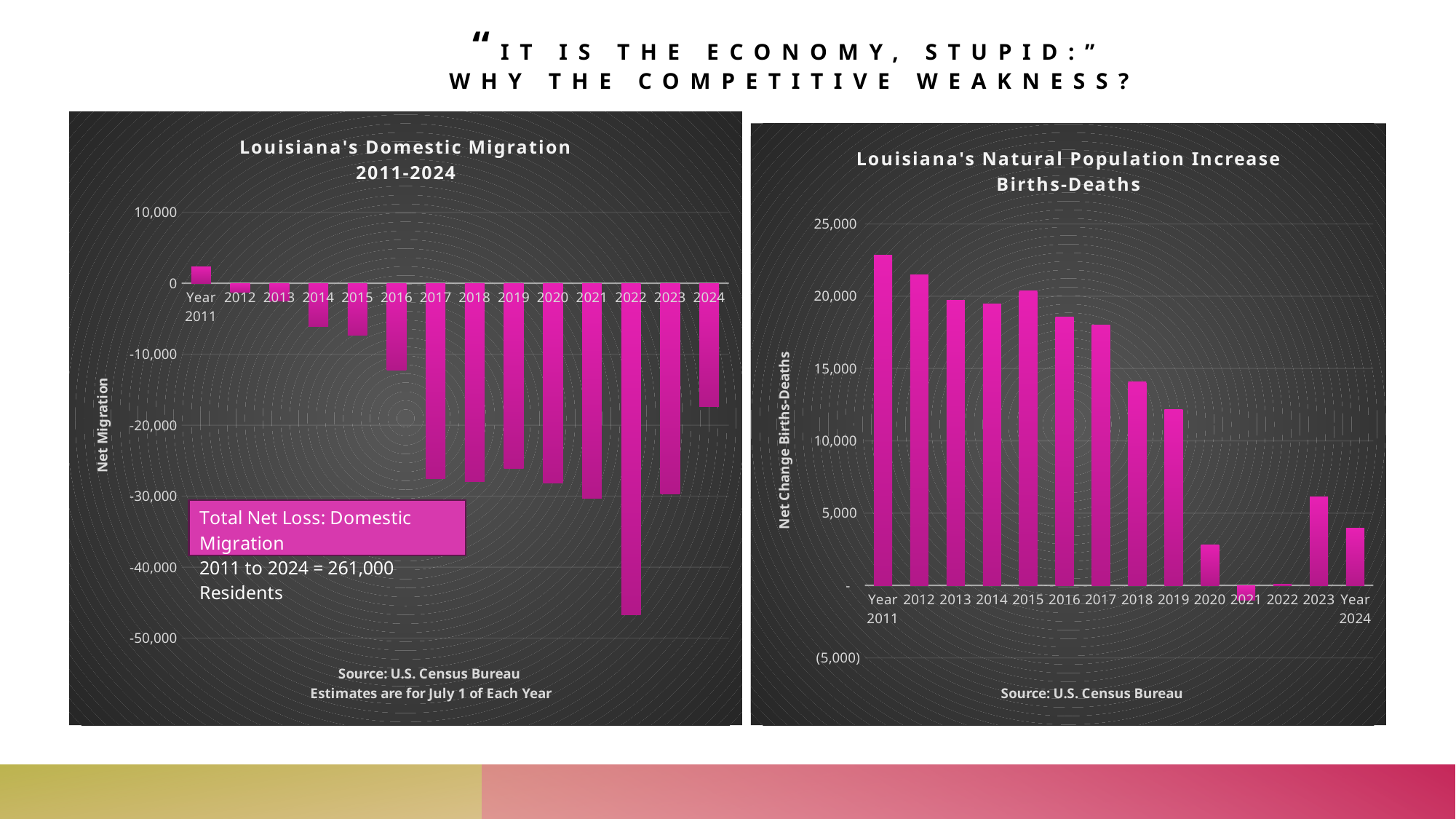
In the "Louisiana's Domestic Migration 2011-2024" chart, which year is the only one with positive net migration? 2011 In the "Louisiana's Domestic Migration 2011-2024" chart, is the value for 2016 greater or less than -10,000? less In the "Louisiana's Natural Population Increase Births-Deaths" chart, which is larger, the value for 2023 or the value for 2024? 2023 In the "Louisiana's Natural Population Increase Births-Deaths" chart, do the values generally rise or fall from 2011 to 2020? fall In the "Louisiana's Domestic Migration 2011-2024" chart, which year has the lowest (most negative) net migration? 2022 In the "Louisiana's Natural Population Increase Births-Deaths" chart, is the value for 2019 greater or less than 10,000? greater What kind of chart is "Louisiana's Domestic Migration 2011-2024"? bar chart How many years are plotted in the "Louisiana's Domestic Migration 2011-2024" chart? 14 In the "Louisiana's Domestic Migration 2011-2024" chart, is the value for 2022 greater or less than -40,000? less How many years are plotted in the "Louisiana's Natural Population Increase Births-Deaths" chart? 14 According to the text box on the "Louisiana's Domestic Migration 2011-2024" chart, what is the total net loss from domestic migration from 2011 to 2024? 261,000 Residents In the "Louisiana's Natural Population Increase Births-Deaths" chart, which year has the highest value? 2011